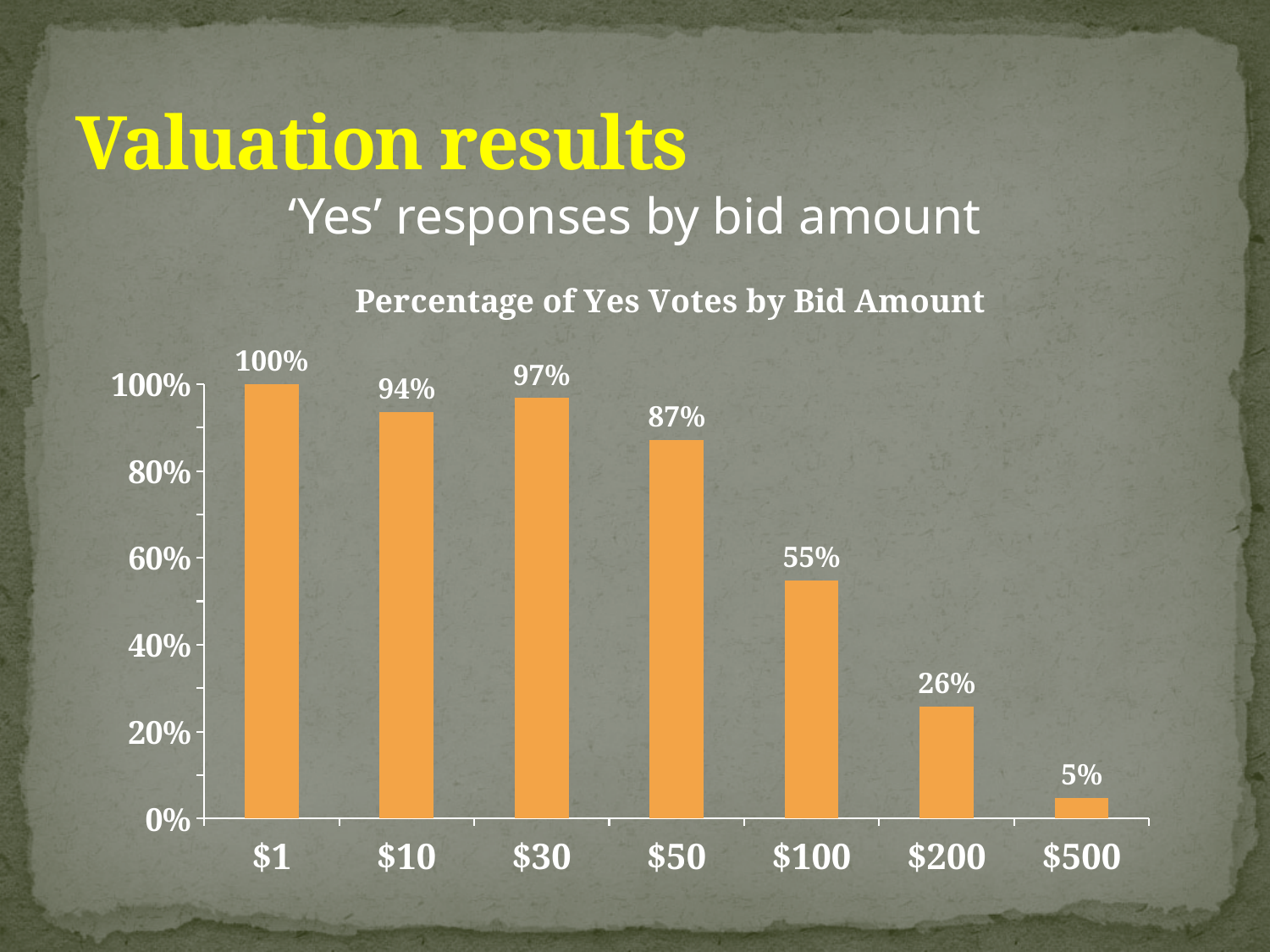
Is the percentage of Yes votes for the $100 bid amount greater or less than 60%? less Which has a higher percentage of Yes votes, the $10 bid or the $30 bid? $30 Which bid amount has the lowest percentage of Yes votes? $500 What is the title of the chart? Percentage of Yes Votes by Bid Amount What is the difference in percentage of Yes votes between the $1 and $50 bid amounts? 13% What is the percentage of Yes votes for the $10 bid amount? 94% What is the difference in percentage of Yes votes between the $100 and $200 bid amounts? 29% How many bid amounts are shown on the x axis of the chart? 7 What kind of chart is used to show the percentage of Yes votes by bid amount? bar chart Which bid amount has the highest percentage of Yes votes? $1 What is the percentage of Yes votes for the $200 bid amount? 26% What is the percentage of Yes votes for the $50 bid amount? 87%